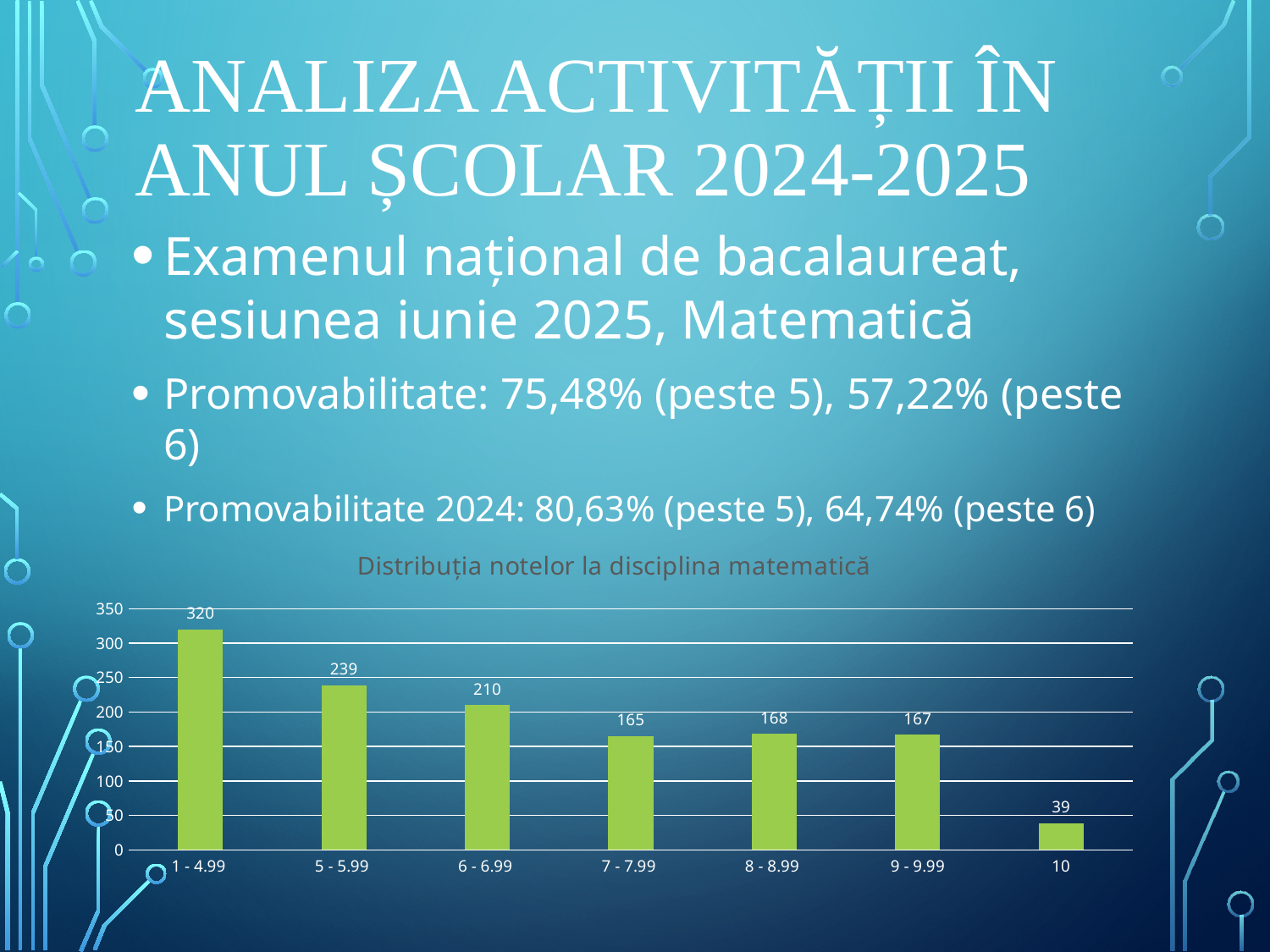
Which category has the lowest value? 10 What is the value for the 1 - 4.99 category? 320 What is the title of the chart? Distribuția notelor la disciplina matematică How many categories are shown on the x axis? 7 What kind of chart is shown on the slide? bar chart Which is larger, the value for 5 - 5.99 or the value for 6 - 6.99? 5 - 5.99 What is the value for the 10 category? 39 What is the value for the 6 - 6.99 category? 210 What is the difference between the values for 1 - 4.99 and 5 - 5.99? 81 Is the value for 7 - 7.99 greater or less than 200? less What is the difference between the values for 9 - 9.99 and 10? 128 Which category has the highest value? 1 - 4.99